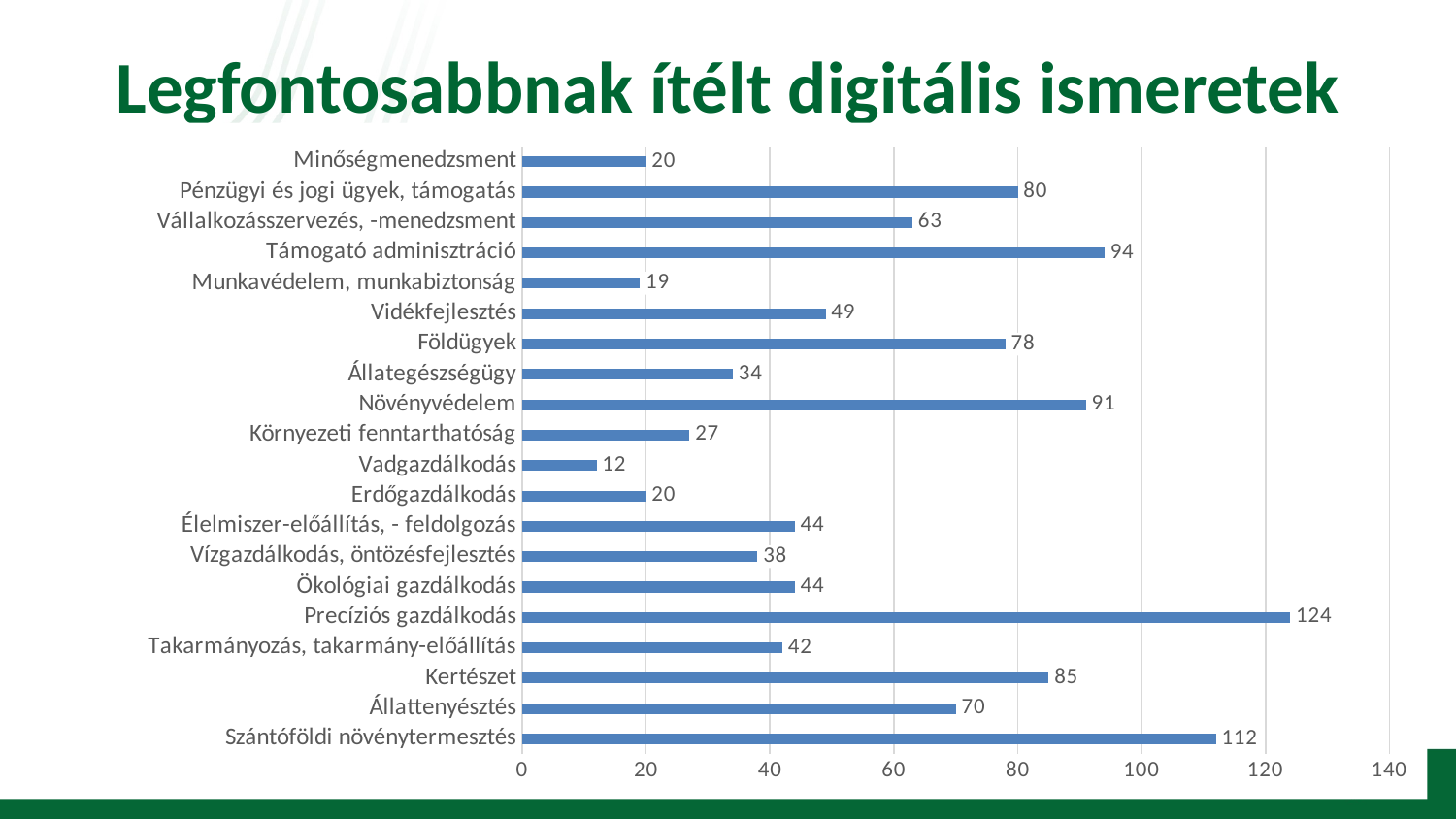
How many categories are shown in the chart? 20 What is the difference between the values for Precíziós gazdálkodás and Szántóföldi növénytermesztés? 12 Which category has the highest value? Precíziós gazdálkodás Which category has the lowest value? Vadgazdálkodás What is the value for Vadgazdálkodás? 12 What is the value for Precíziós gazdálkodás? 124 What is the value for Növényvédelem? 91 Is the value for Pénzügyi és jogi ügyek, támogatás greater or less than 100? less What is the value for Kertészet? 85 Which is larger, the value for Állattenyésztés or the value for Vállalkozásszervezés, -menedzsment? Állattenyésztés What is the difference between the values for Támogató adminisztráció and Földügyek? 16 What type of chart is shown on the slide? Bar chart